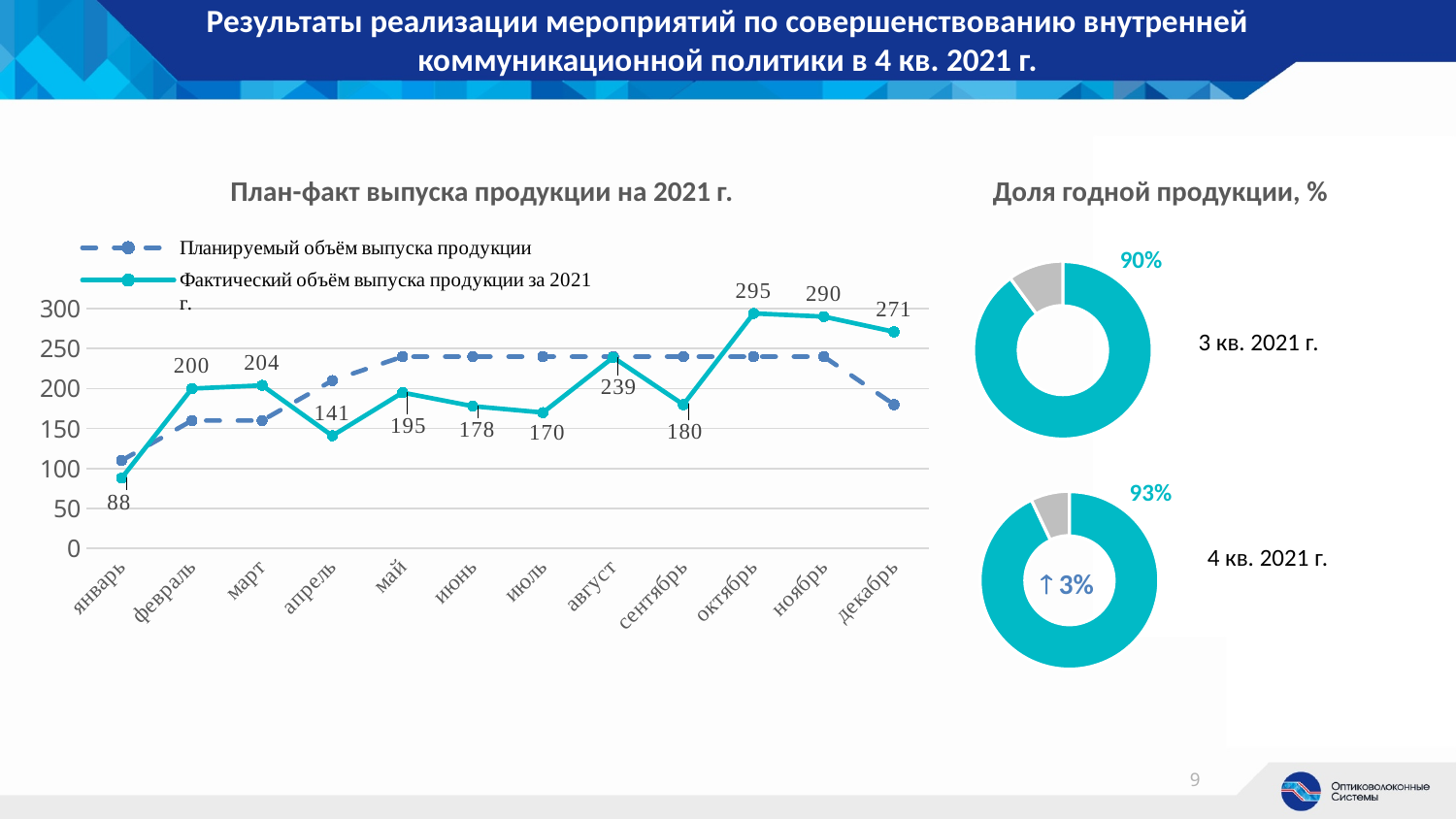
In the chart 'План-факт выпуска продукции на 2021 г.', what is the actual output for январь? 88 In the chart 'Доля годной продукции, %', what is the difference between the share for 4 кв. 2021 г. and 3 кв. 2021 г.? 3% How many months are shown on the x axis of the chart 'План-факт выпуска продукции на 2021 г.'? 12 In the chart 'План-факт выпуска продукции на 2021 г.', which month has the lowest actual output? январь What type of chart is 'План-факт выпуска продукции на 2021 г.'? line chart In the chart 'Доля годной продукции, %', what is the share of good products for 4 кв. 2021 г.? 93% In the chart 'План-факт выпуска продукции на 2021 г.', which month has the highest actual output? октябрь In the chart 'План-факт выпуска продукции на 2021 г.', is the planned output (Планируемый объём) for июнь greater or less than 200? greater In the chart 'План-факт выпуска продукции на 2021 г.', what is the actual output (Фактический объём) for октябрь? 295 How many series does the legend of the chart 'План-факт выпуска продукции на 2021 г.' list? 2 In the chart 'План-факт выпуска продукции на 2021 г.', is the actual output higher in март or in апрель? март In the chart 'План-факт выпуска продукции на 2021 г.', what is the difference between the actual output in октябрь and in сентябрь? 115